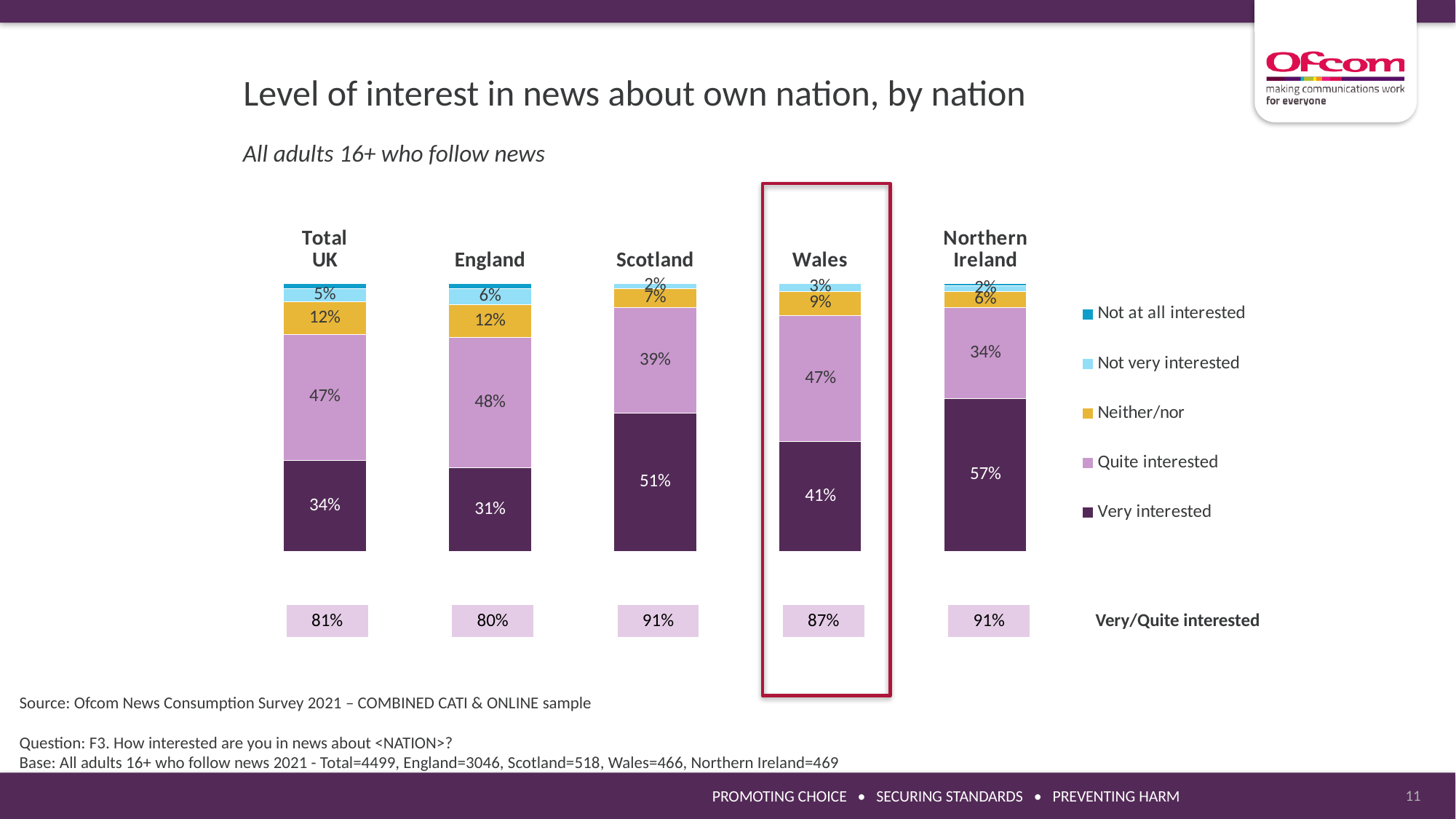
How many bars (nations/groups) are shown in the chart? 5 How many series does the legend list? 5 What percentage of adults in Wales are very interested in news about their own nation? 41% Which has a larger 'Quite interested' value, England or Total UK? England What is the 'Neither/nor' value for Total UK? 12% Which nation's bar is highlighted with a red outline box? Wales Which bar has the lowest 'Very interested' value? England What kind of chart is shown on the slide? Stacked bar chart Which nation has the highest 'Very interested' value? Northern Ireland What is the combined Very/Quite interested figure shown for Wales? 87% What is the 'Quite interested' value for Scotland? 39% What is the difference in the 'Very interested' value between Scotland and Wales? 10 percentage points